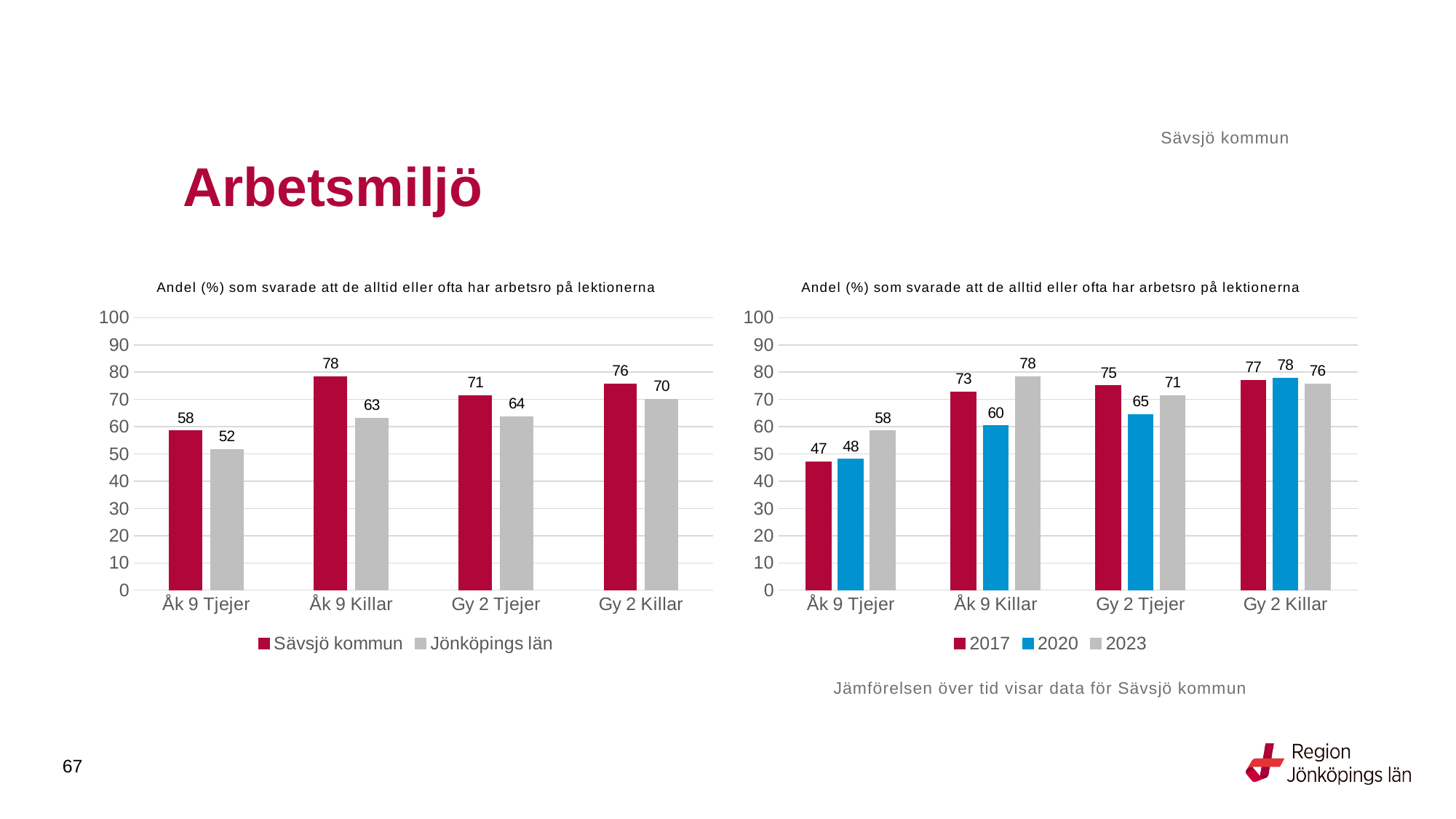
What type of chart is the right chart? Bar chart How many categories are shown on the x axis of the left chart? 4 In the left chart, which is larger for Gy 2 Tjejer: Sävsjö kommun or Jönköpings län? Sävsjö kommun In the right chart, what is the difference between the 2023 and 2017 values for Åk 9 Tjejer? 11 In the right chart, which category has the highest value for 2023? Åk 9 Killar In the right chart, what is the value for 2017 for Åk 9 Tjejer? 47 In the left chart, what is the value for Jönköpings län for Åk 9 Tjejer? 52 In the left chart, what is the difference between Sävsjö kommun and Jönköpings län for Åk 9 Killar? 15 In the left chart, what is the value for Sävsjö kommun for Åk 9 Killar? 78 In the left chart, which category has the lowest value for Sävsjö kommun? Åk 9 Tjejer In the right chart, what is the value for 2020 for Gy 2 Tjejer? 65 How many series does the legend of the right chart list? 3